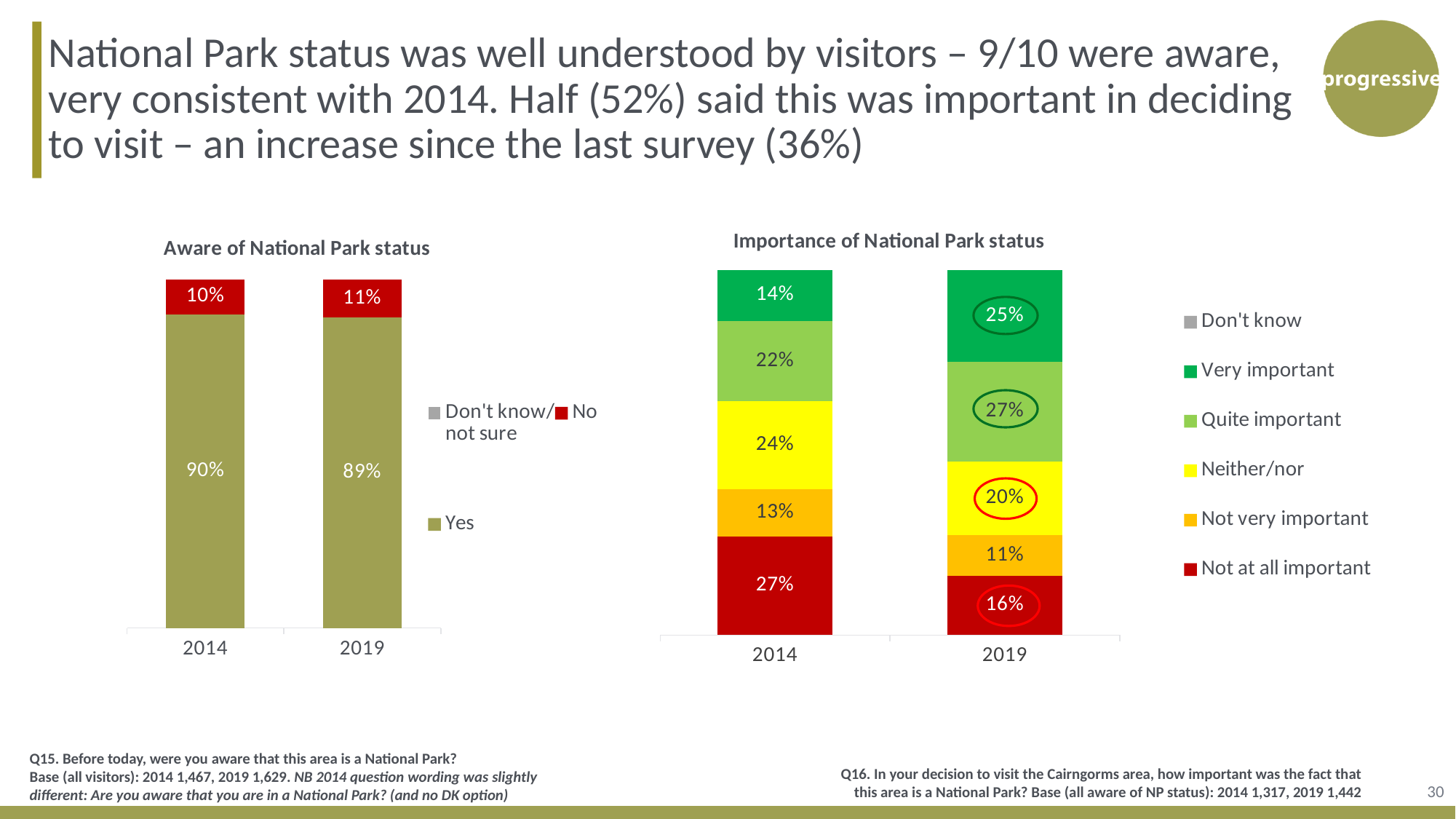
In the 'Importance of National Park status' chart, what percentage said Not at all important in 2014? 27% What kind of chart is 'Aware of National Park status'? Stacked bar chart In the 'Importance of National Park status' chart, is the Very important share larger in 2014 or 2019? 2019 In the 'Importance of National Park status' chart, what is the difference between the Not at all important values for 2014 and 2019? 11% How many years are shown on the x axis of the 'Importance of National Park status' chart? 2 In the 'Aware of National Park status' chart, what percentage answered Yes in 2014? 90% In the 'Importance of National Park status' chart, what percentage said Very important in 2019? 25% In the 'Importance of National Park status' chart, which category has the largest share in 2019? Quite important In the 'Aware of National Park status' chart, what percentage answered No in 2019? 11% In the 'Importance of National Park status' chart, which category has the smallest share in 2019? Not very important How many series does the legend of the 'Importance of National Park status' chart list? 6 In the 'Aware of National Park status' chart, what is the difference between the Yes values for 2014 and 2019? 1%